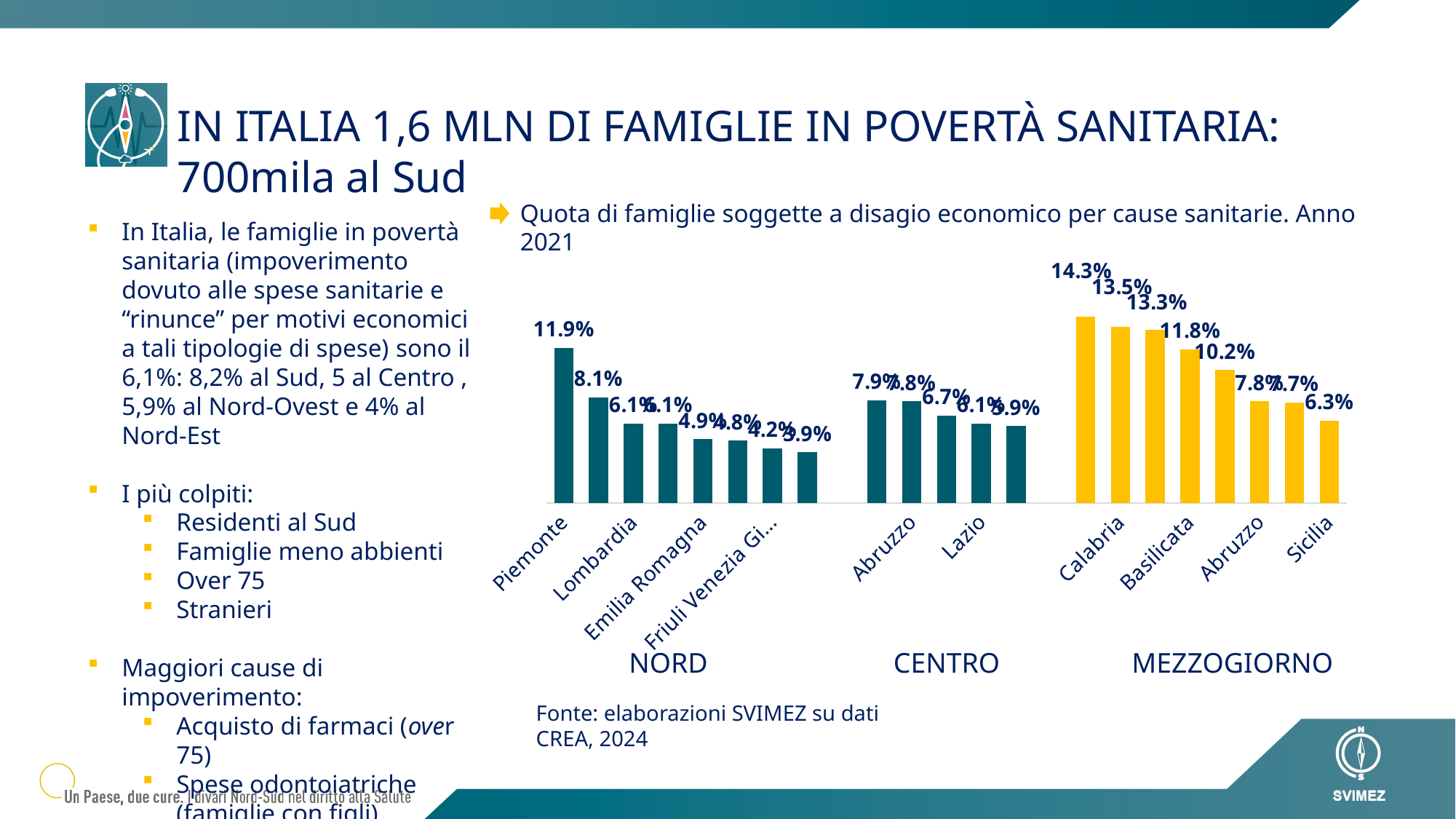
What is the difference between the highest value in the chart (14.3%) and the lowest value (3.9%)? 10.4% What is the highest value among the NORD bars? 11.9% What is the lowest value shown in the whole chart? 3.9% How many bars are in the CENTRO group? 5 What kind of chart is shown on the slide? bar chart How many bars are in the MEZZOGIORNO group? 8 What is the value shown for Piemonte? 11.9% Into how many macro-area groups (NORD, CENTRO, MEZZOGIORNO) are the bars divided? 3 Which is larger: the value for Piemonte or the highest MEZZOGIORNO bar? the highest MEZZOGIORNO bar What colour are the MEZZOGIORNO bars? yellow What is the highest value shown in the whole chart? 14.3% What is the lowest value among the CENTRO bars? 5.9%